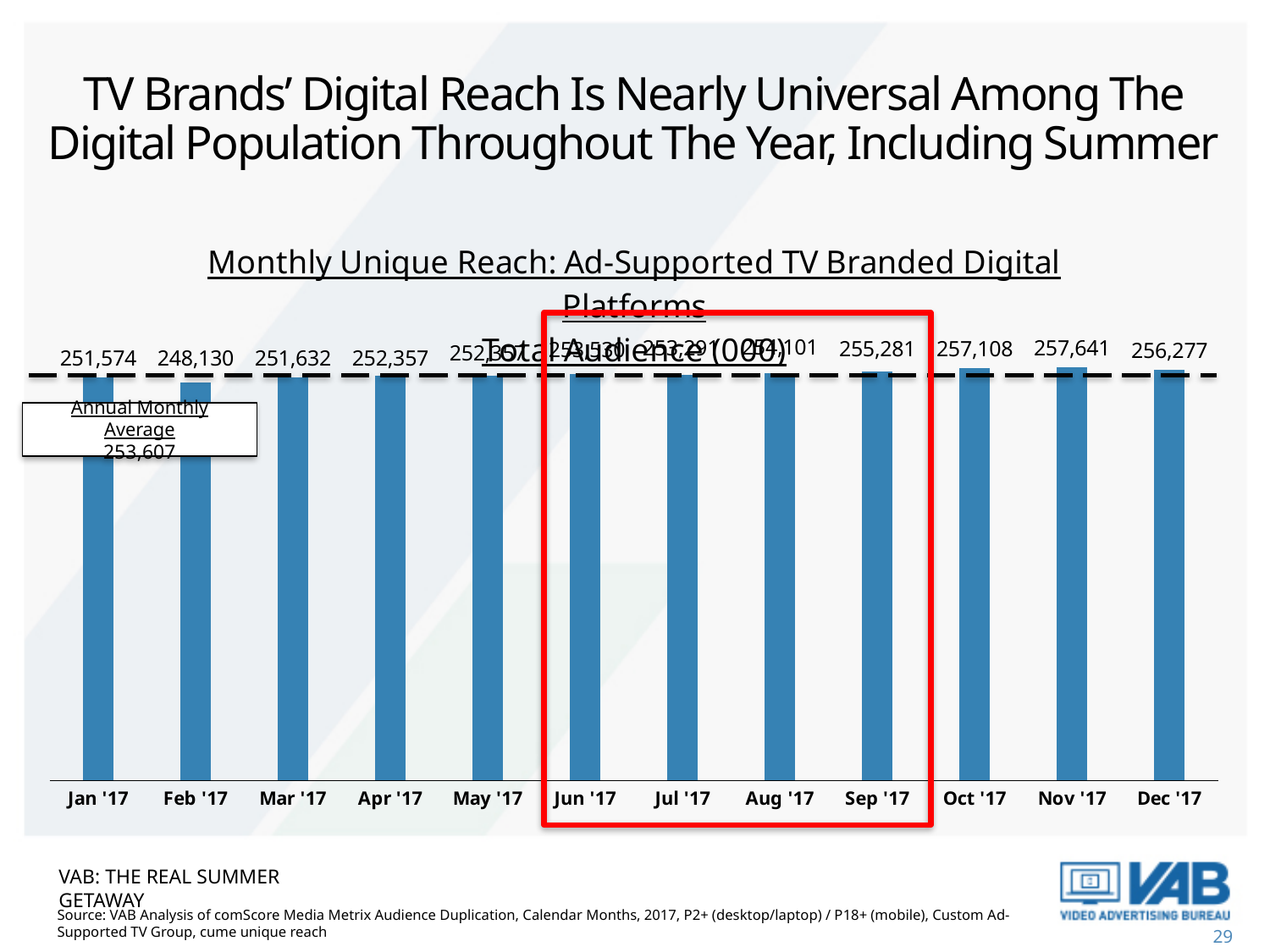
Which month has the lowest value? Feb '17 What is the value for Dec '17? 256,277 What is the value for Feb '17? 248,130 What is the difference between the values for Nov '17 and Feb '17? 9,511 What is the difference between the values for Oct '17 and Sep '17? 1,827 What is the value for Sep '17? 255,281 What is the value for Jan '17? 251,574 Which month has the highest value? Nov '17 What kind of chart is shown on the slide? Bar chart What is the Annual Monthly Average shown on the chart? 253,607 How many months are shown on the x axis? 12 Which is larger, the value for Mar '17 or Apr '17? Apr '17